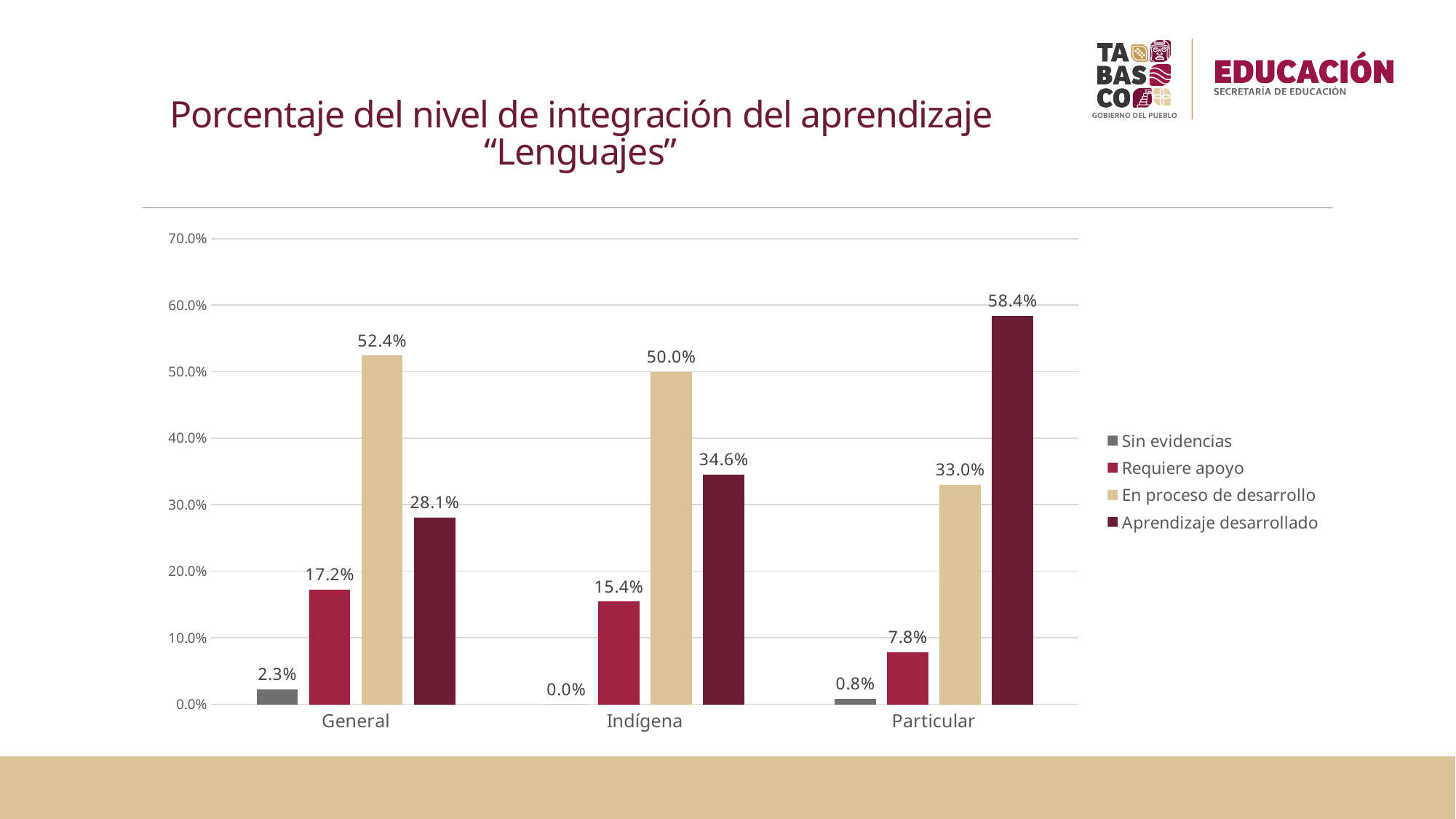
How many series does the legend list? 4 Which category has the lowest value for "Requiere apoyo"? Particular What is the value for "Sin evidencias" in the Indígena category? 0.0% What is the value for "Requiere apoyo" in the Particular category? 7.8% What is the title of the chart on the slide? Porcentaje del nivel de integración del aprendizaje "Lenguajes" How many categories are shown on the x axis? 3 Which category has the highest value for "Aprendizaje desarrollado"? Particular What is the value for "En proceso de desarrollo" in the General category? 52.4% Which is larger in the General category: "Requiere apoyo" or "Aprendizaje desarrollado"? Aprendizaje desarrollado What kind of chart is shown on the slide? Bar chart What is the difference between "En proceso de desarrollo" and "Aprendizaje desarrollado" in the Indígena category? 15.4% What is the value for "Aprendizaje desarrollado" in the Particular category? 58.4%